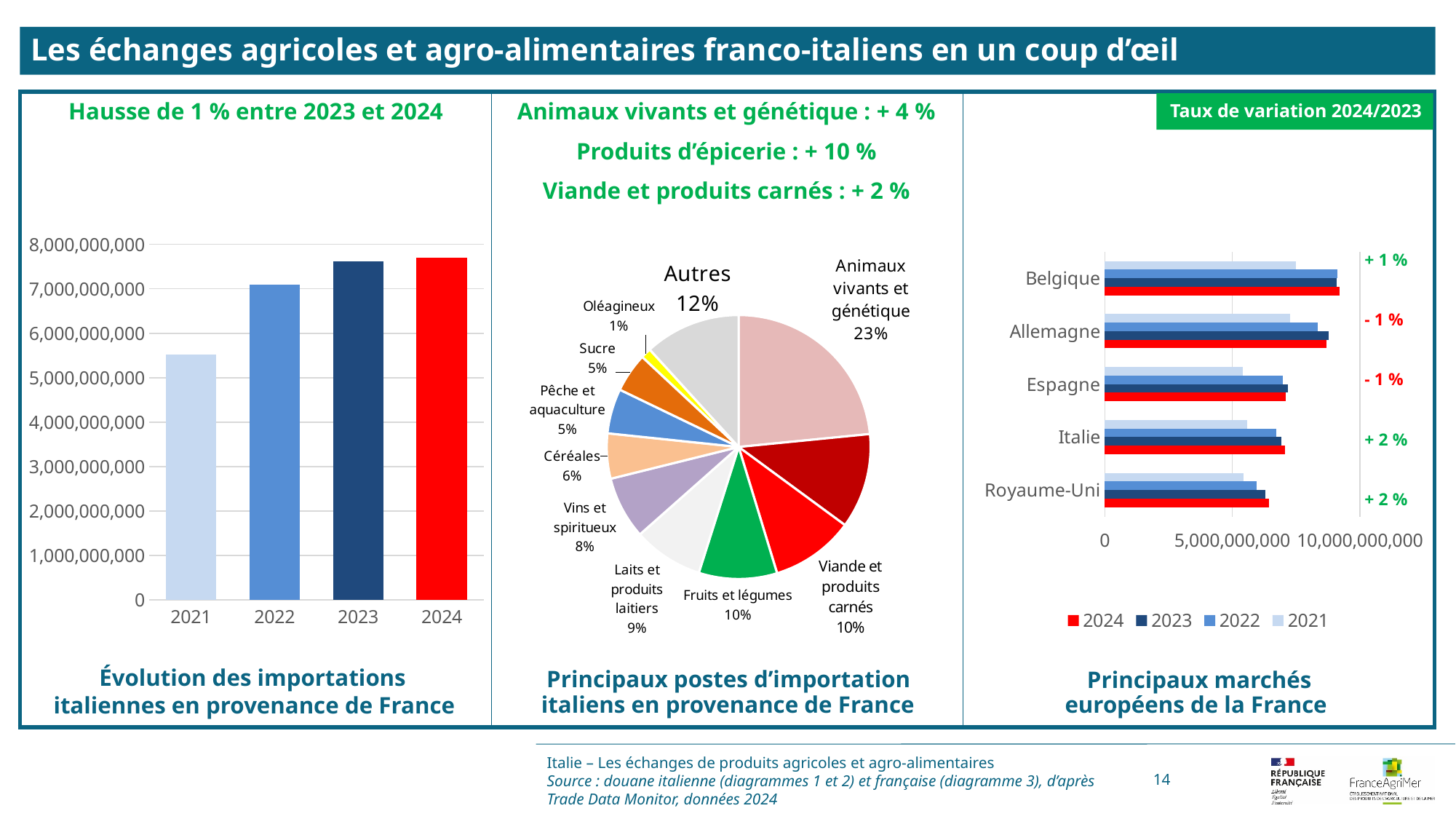
On the chart 'Évolution des importations italiennes en provenance de France', how many years are shown on the x axis? 4 On the pie chart 'Principaux postes d'importation italiens en provenance de France', what is the difference in percentage points between 'Animaux vivants et génétique' and 'Vins et spiritueux'? 15 On the chart 'Évolution des importations italiennes en provenance de France', is the value for 2021 greater or less than 6,000,000,000? less What kind of chart is 'Principaux postes d'importation italiens en provenance de France'? pie chart On the chart 'Principaux marchés européens de la France', how many series does the legend list? 4 On the pie chart 'Principaux postes d'importation italiens en provenance de France', which category has the smallest share? Oléagineux On the chart 'Évolution des importations italiennes en provenance de France', do the values rise or fall from 2021 to 2024? rise On the pie chart 'Principaux postes d'importation italiens en provenance de France', what share does 'Animaux vivants et génétique' have? 23% On the chart 'Principaux marchés européens de la France', which country has the highest 2024 value? Belgique On the chart 'Principaux marchés européens de la France', is the 2024 value for Italie greater or less than 5,000,000,000? greater On the pie chart 'Principaux postes d'importation italiens en provenance de France', how many slices are there? 11 On the chart 'Évolution des importations italiennes en provenance de France', which year has the lowest value? 2021